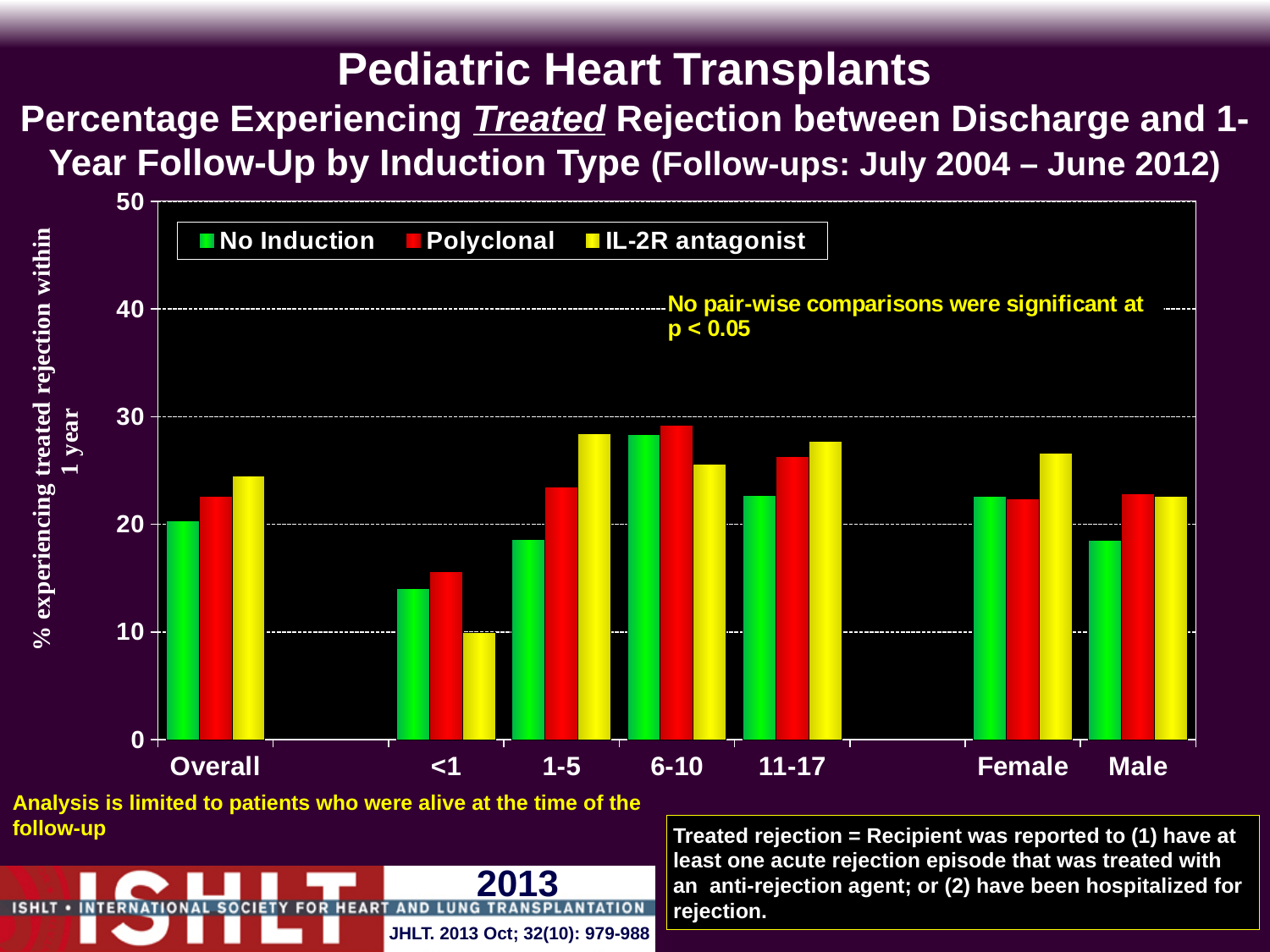
What kind of chart is shown on the slide? bar chart Is the value for No Induction in the <1 age group greater or less than 20? less Which colour represents the Polyclonal series in the legend? red In the <1 age group, which is larger: No Induction or IL-2R antagonist? No Induction In the 1-5 age group, which is larger: No Induction or IL-2R antagonist? IL-2R antagonist Is the value for Polyclonal in the 6-10 age group greater or less than 20? greater Which category has the highest value for No Induction? 6-10 How many series does the legend list? 3 Is the value for IL-2R antagonist in the 1-5 age group greater or less than 20? greater Which category has the lowest value for IL-2R antagonist? <1 How many categories are shown along the x axis? 7